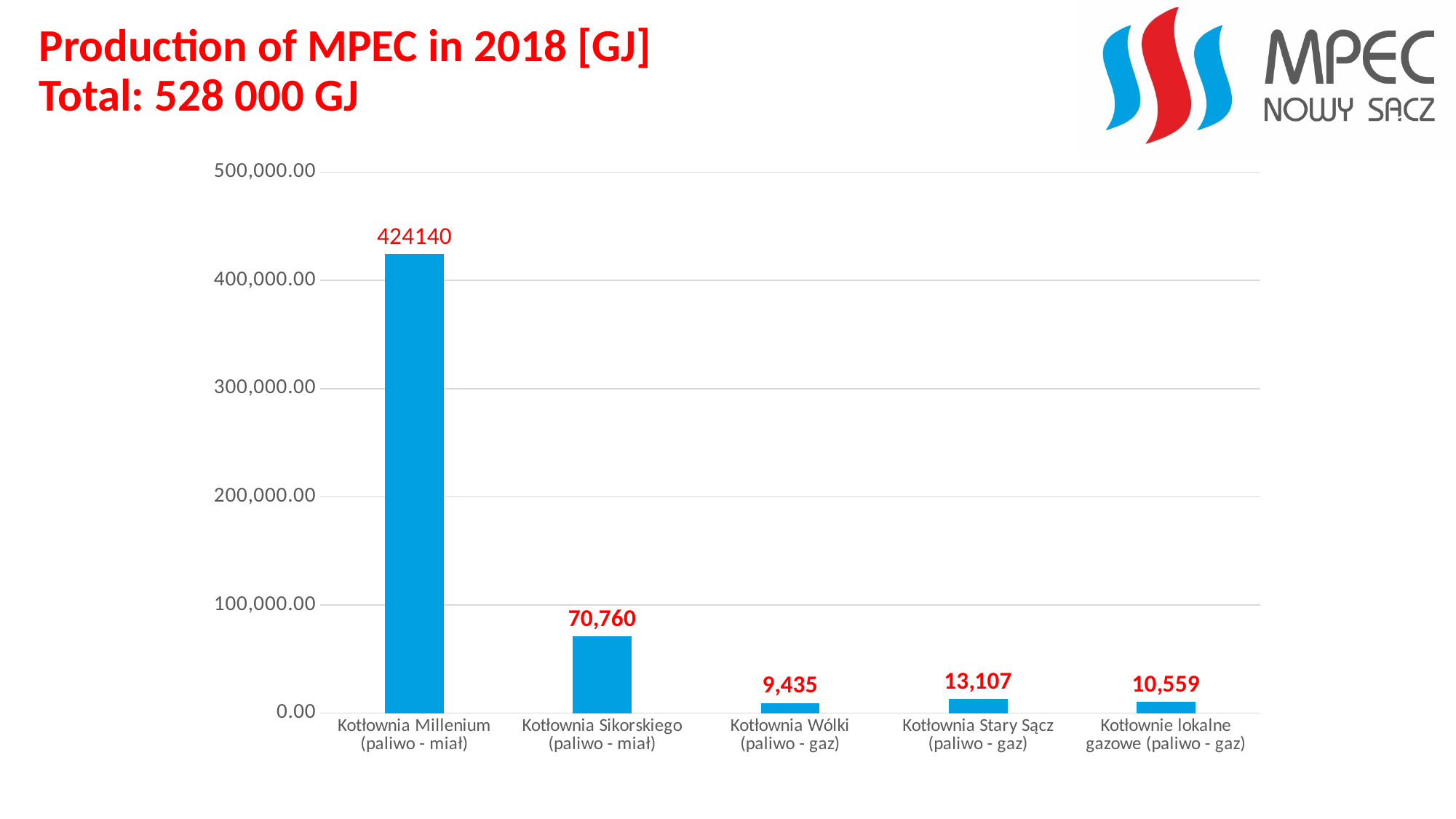
What is the production value for Kotłownia Millenium (paliwo - miał)? 424140 How many categories are shown in the chart? 5 What is the production value for Kotłownie lokalne gazowe (paliwo - gaz)? 10,559 Which is larger, the production of Kotłownia Stary Sącz or Kotłownie lokalne gazowe? Kotłownia Stary Sącz What is the production value for Kotłownia Sikorskiego (paliwo - miał)? 70,760 What is the production value for Kotłownia Wólki (paliwo - gaz)? 9,435 What type of chart is shown on the slide? Bar chart What is the difference between the production of Kotłownia Stary Sącz and Kotłownia Wólki? 3,672 Which category has the highest production? Kotłownia Millenium (paliwo - miał) What is the difference between the production of Kotłownia Millenium and Kotłownia Sikorskiego? 353,380 What is the production value for Kotłownia Stary Sącz (paliwo - gaz)? 13,107 Which category has the lowest production? Kotłownia Wólki (paliwo - gaz)